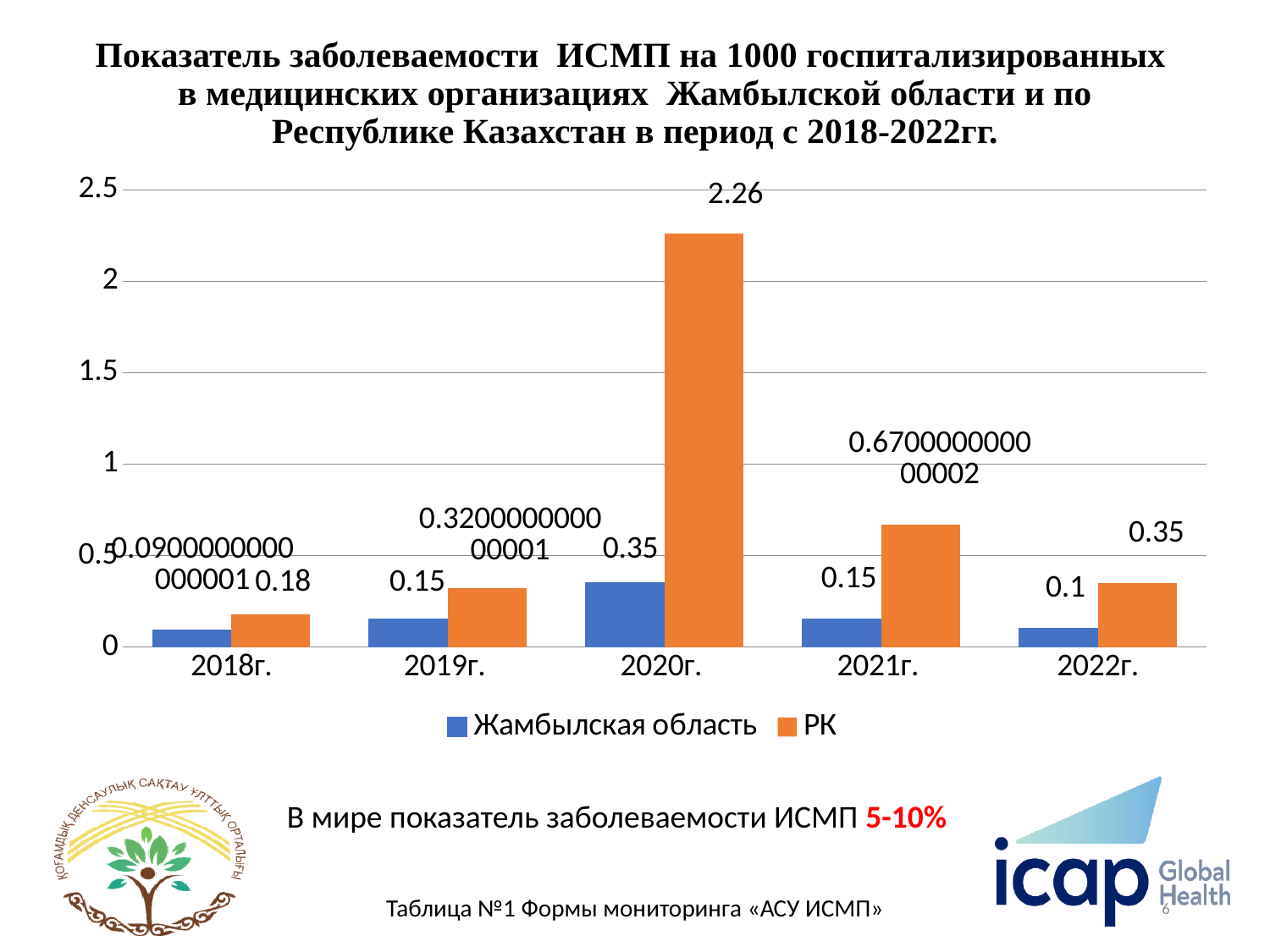
What is the value for Жамбылская область in 2020г.? 0.35 What is the value for РК in 2020г.? 2.26 In 2022г., which series has the larger value, Жамбылская область or РК? РК What kind of chart is shown on the slide? bar chart What is the difference between the РК value and the Жамбылская область value in 2020г.? 1.91 What is the value for РК in 2018г.? 0.18 What is the value for Жамбылская область in 2019г.? 0.15 How many years are shown on the x axis? 5 In which year is the РК value highest? 2020г. How many series does the legend list? 2 Is the value for РК in 2021г. greater or less than 0.5? greater What is the value for Жамбылская область in 2022г.? 0.1